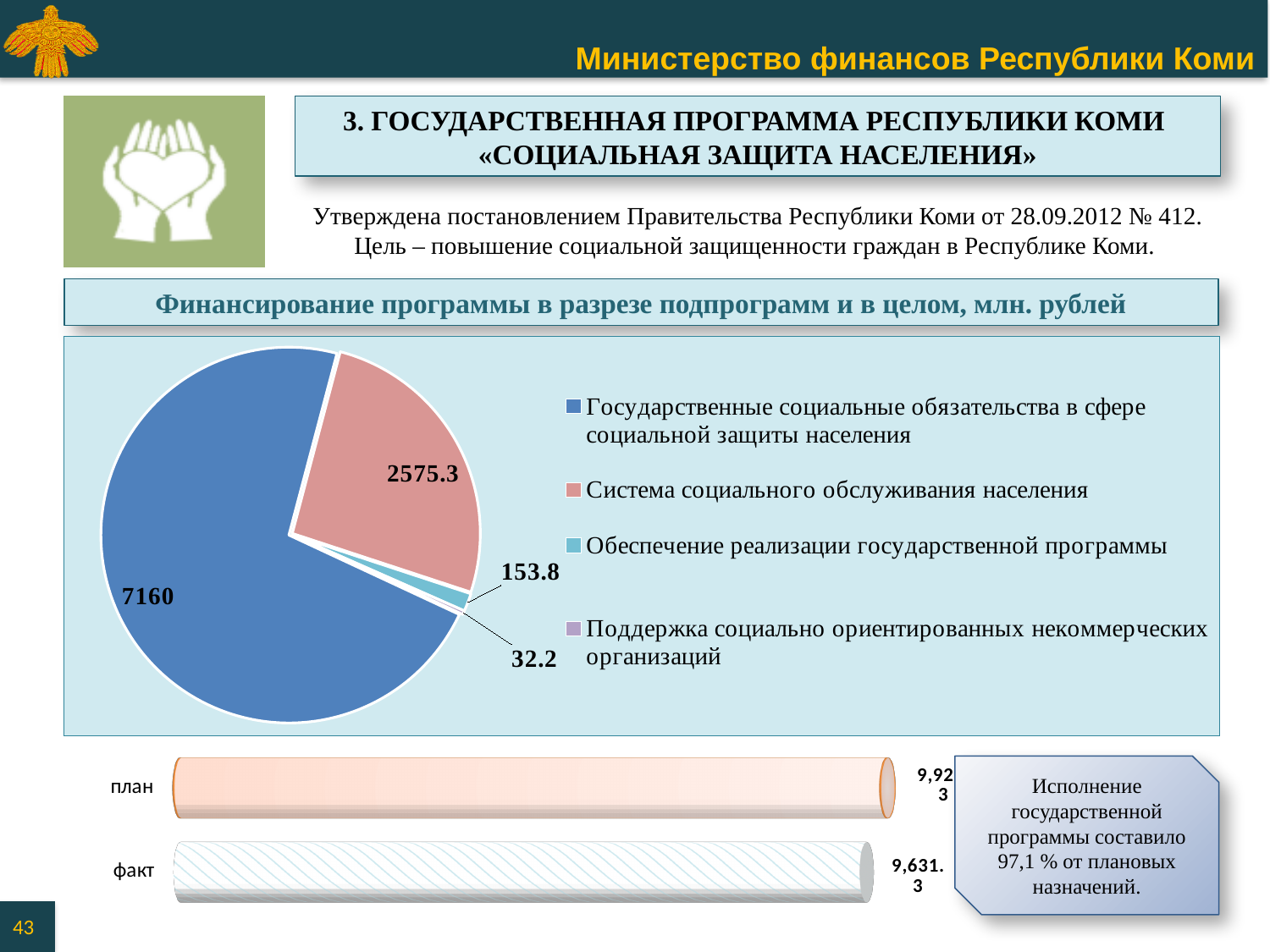
How many slices does the pie chart have? 4 In the pie chart, which subprogram has the smallest slice? Поддержка социально ориентированных некоммерческих организаций What type of chart is the upper chart on the slide? Pie chart In the pie chart, what is the difference between the values 7160 and 2575.3? 4584.7 How many entries does the legend of the pie chart list? 4 In the bar chart at the bottom, what is the value for «факт»? 9,631.3 In the pie chart, what is the value for «Система социального обслуживания населения»? 2575.3 In the pie chart, what is the value for «Государственные социальные обязательства в сфере социальной защиты населения»? 7160 In the bar chart at the bottom, which is larger, «план» or «факт»? план In the pie chart, which subprogram has the largest slice? Государственные социальные обязательства в сфере социальной защиты населения In the pie chart, what is the value for «Обеспечение реализации государственной программы»? 153.8